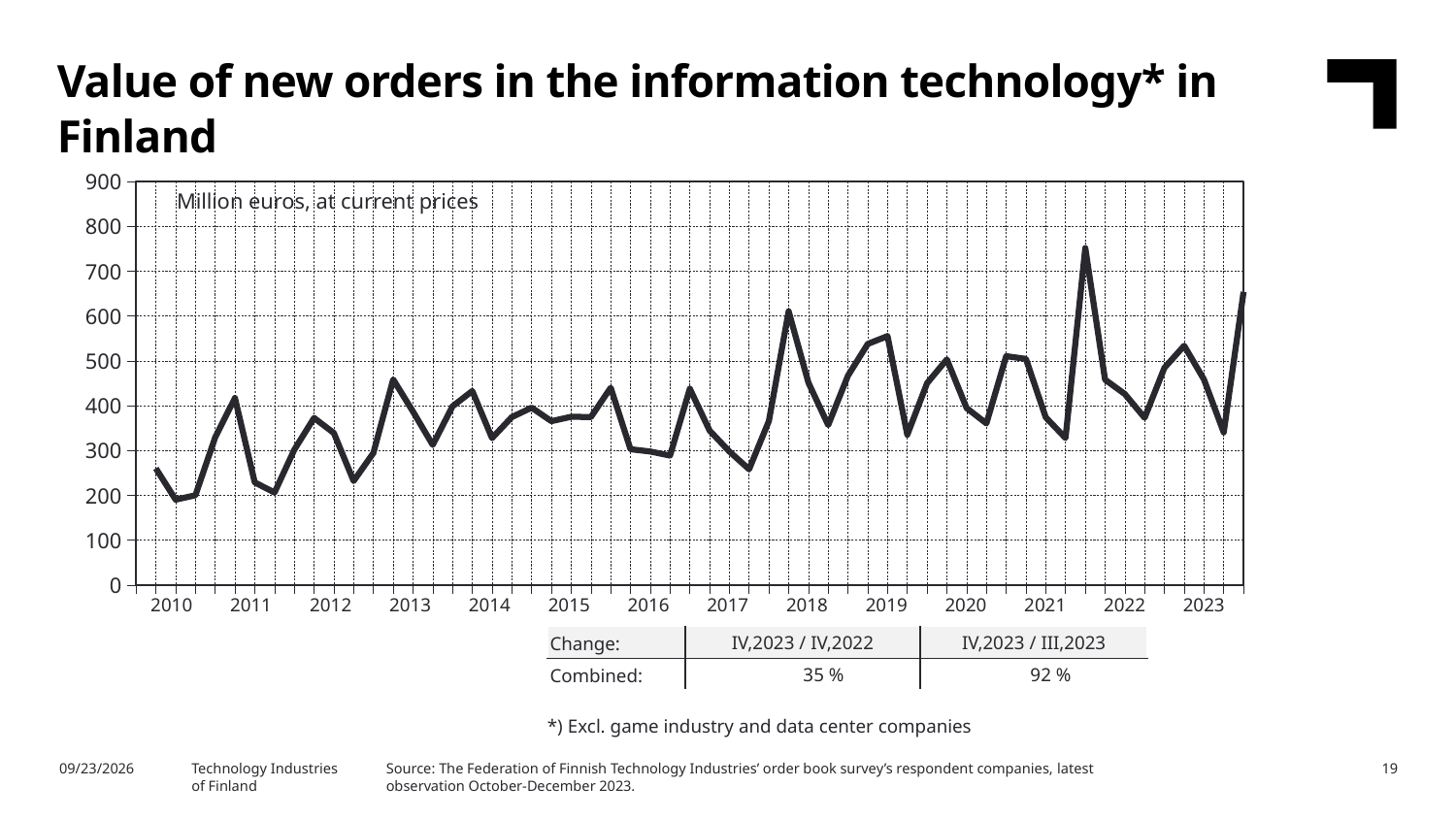
In which year does the line reach its highest peak? 2021 What is the combined change for IV,2023 / IV,2022 shown in the table below the chart? 35 % What type of chart is shown on the slide? Line chart What is the title of the chart? Value of new orders in the information technology* in Finland Is the value at the last point of the line, at the end of 2023, greater or less than 600? greater Is the highest peak of the line, in 2021, greater or less than 700? greater Which is higher: the peak of the line in 2021 or the peak in 2018? 2021 Is the value at the first point of the line, at the start of 2010, greater or less than 300? less How many years are labeled on the x axis of the chart? 14 What is the combined change for IV,2023 / III,2023 shown in the table below the chart? 92 % In what unit are the values on the chart expressed, according to the label inside the plot area? Million euros, at current prices